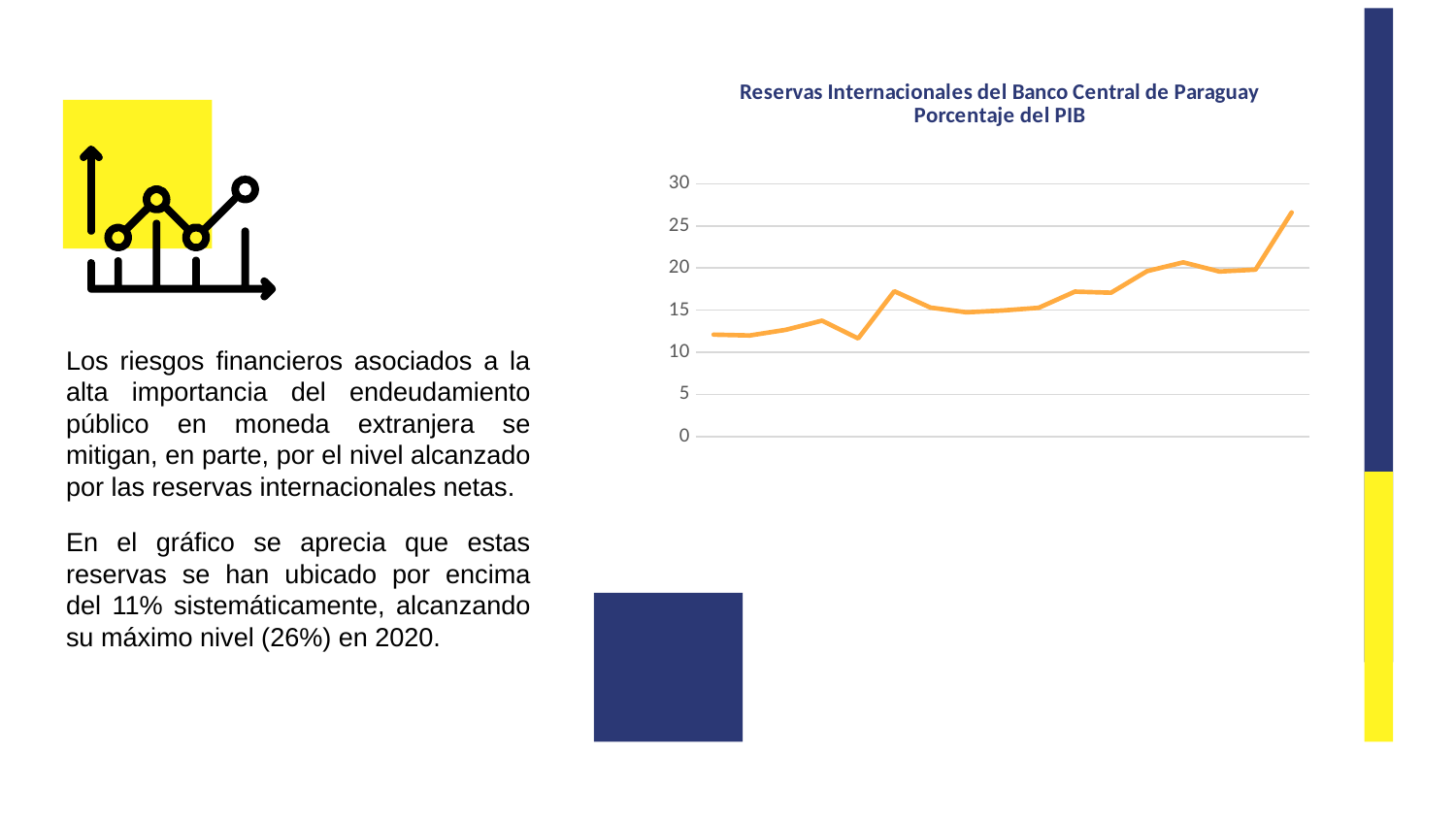
Overall, do the values in the chart rise or fall from left to right? rise Is the value at the first point of the line greater or less than 10? greater What is the title of the chart? Reservas Internacionales del Banco Central de Paraguay Porcentaje del PIB What is the maximum value shown on the vertical axis? 30 Where along the x axis does the highest value of the line occur? at the far right (last point) Which is larger, the value at the first point of the line or the value at the last point? the last point What kind of chart is shown on the slide? line chart Is the value at the first point of the line greater or less than 15? less Is the value at the last point of the line greater or less than 25? greater How many lines are plotted in the chart? 1